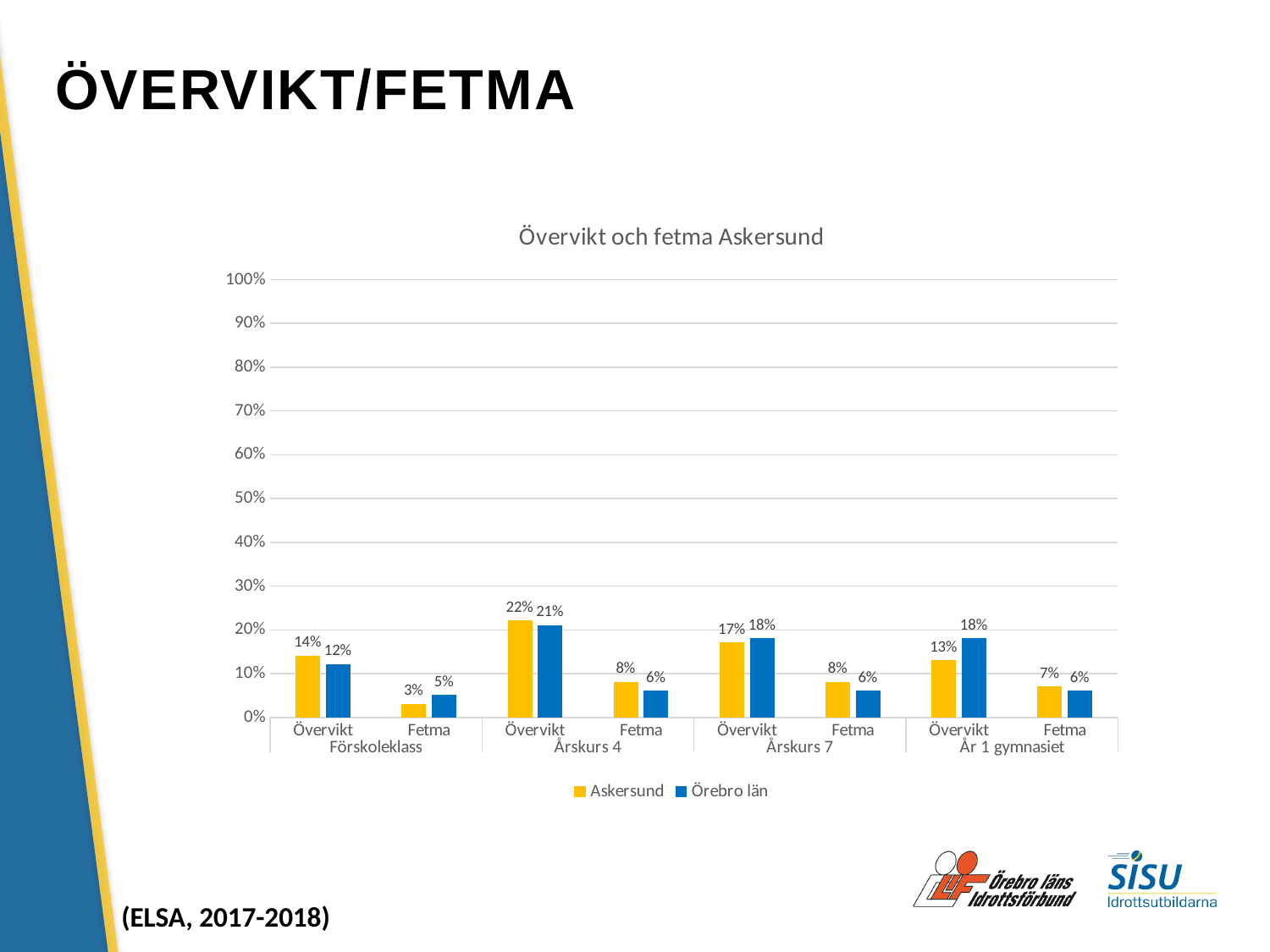
Which colour represents Askersund in the chart? Yellow What is the Örebro län value for Fetma in Årskurs 4? 6% What kind of chart is shown on the slide? Bar chart What is the title of the chart? Övervikt och fetma Askersund Which category has the lowest Askersund value? Fetma, Förskoleklass What is the difference between the Askersund and Örebro län values for Övervikt in År 1 gymnasiet? 5% Is the Askersund value for Övervikt in Årskurs 4 greater or less than 20%? greater What is the Askersund value for Övervikt in Förskoleklass? 14% What is the Askersund value for Övervikt in År 1 gymnasiet? 13% For Övervikt in Årskurs 7, which is larger: Askersund or Örebro län? Örebro län Which category has the highest Askersund value? Övervikt, Årskurs 4 How many series does the legend list? 2